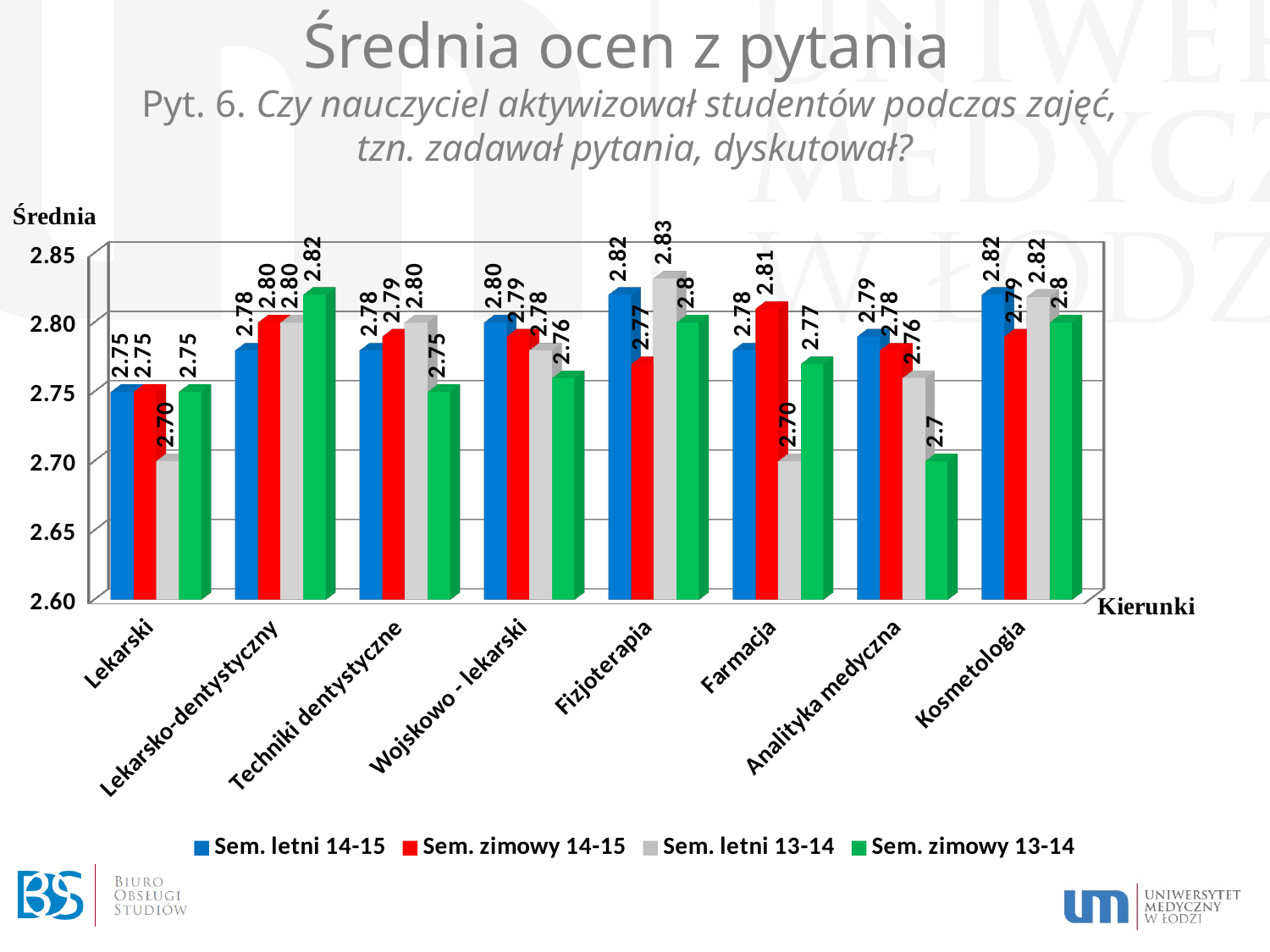
What kind of chart is shown on the slide? Bar chart What is the difference between the Sem. zimowy 14-15 and Sem. letni 13-14 values for Farmacja? 0.11 How many series does the legend list? 4 Which category has the lowest value in the Sem. letni 14-15 series? Lekarski What is the value for Farmacja in the Sem. zimowy 14-15 series? 2.81 Which category has the highest value in the Sem. zimowy 13-14 series? Lekarsko-dentystyczny What is the value for Analityka medyczna in the Sem. zimowy 13-14 series? 2.7 How many categories (kierunki) are shown on the x axis? 8 Which is larger for Wojskowo - lekarski: the Sem. letni 14-15 value or the Sem. zimowy 13-14 value? Sem. letni 14-15 Which colour represents the Sem. letni 13-14 series? Grey What is the value for Lekarski in the Sem. letni 14-15 series? 2.75 What is the value for Fizjoterapia in the Sem. letni 13-14 series? 2.83